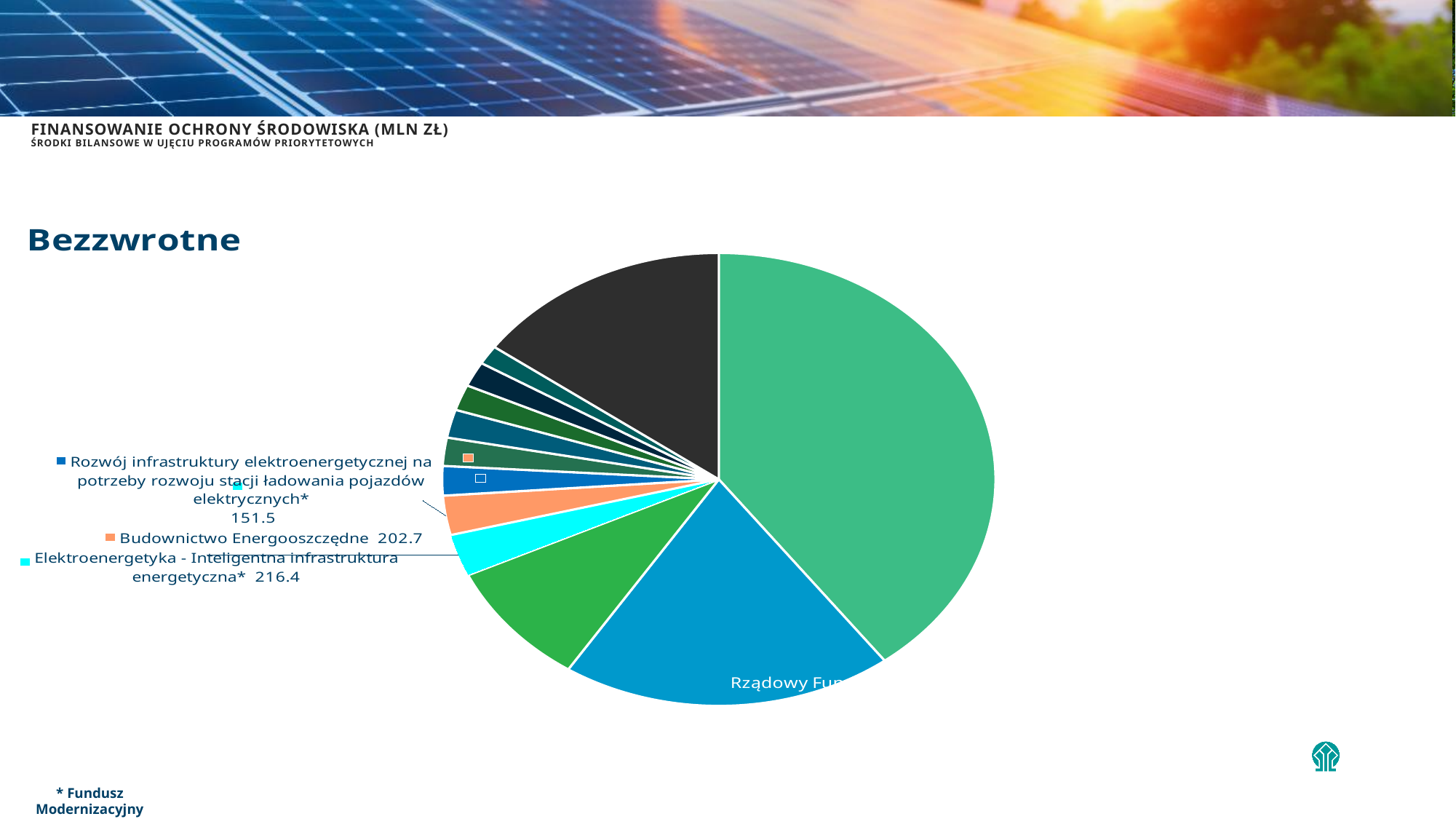
What is the difference between the values for Budownictwo Energooszczędne and Rozwój infrastruktury elektroenergetycznej na potrzeby rozwoju stacji ładowania pojazdów elektrycznych*? 51.2 What is the value for Rozwój infrastruktury elektroenergetycznej na potrzeby rozwoju stacji ładowania pojazdów elektrycznych*? 151.5 What is the difference between the values for Elektroenergetyka - Inteligentna infrastruktura energetyczna* and Budownictwo Energooszczędne? 13.7 What is the title of the pie chart? Bezzwrotne What is the value for Elektroenergetyka - Inteligentna infrastruktura energetyczna*? 216.4 What is the difference between the values for Elektroenergetyka - Inteligentna infrastruktura energetyczna* and Rozwój infrastruktury elektroenergetycznej na potrzeby rozwoju stacji ładowania pojazdów elektrycznych*? 64.9 What is the value for Budownictwo Energooszczędne? 202.7 According to the footnote, what does the asterisk (*) in the slice labels stand for? Fundusz Modernizacyjny Of the three slices with printed values, which has the smallest value? Rozwój infrastruktury elektroenergetycznej na potrzeby rozwoju stacji ładowania pojazdów elektrycznych* What kind of chart is shown on the slide? pie chart Which is larger: Elektroenergetyka - Inteligentna infrastruktura energetyczna* or Budownictwo Energooszczędne? Elektroenergetyka - Inteligentna infrastruktura energetyczna* Which is larger: Budownictwo Energooszczędne or Rozwój infrastruktury elektroenergetycznej na potrzeby rozwoju stacji ładowania pojazdów elektrycznych*? Budownictwo Energooszczędne